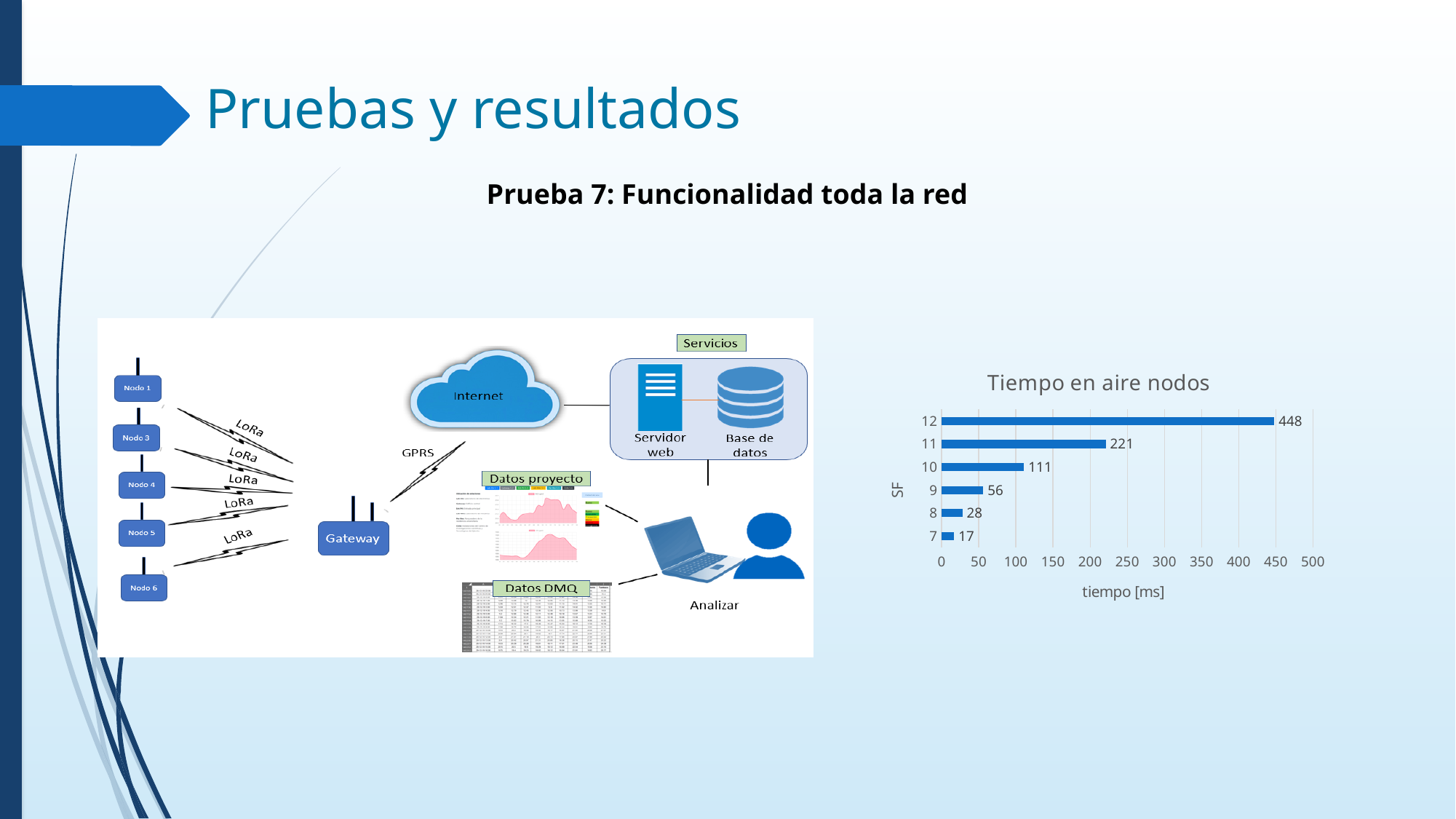
What is the value for SF 12 in the 'Tiempo en aire nodos' chart? 448 How many SF categories are shown in the 'Tiempo en aire nodos' chart? 6 What is the value for SF 9 in the 'Tiempo en aire nodos' chart? 56 Is the value for SF 11 in the 'Tiempo en aire nodos' chart greater or less than 200? greater What is the x-axis label of the 'Tiempo en aire nodos' chart? tiempo [ms] What is the value for SF 7 in the 'Tiempo en aire nodos' chart? 17 What is the difference between the values for SF 12 and SF 11 in the 'Tiempo en aire nodos' chart? 227 What is the difference between the values for SF 10 and SF 8 in the 'Tiempo en aire nodos' chart? 83 Which SF has the lowest time on air in the 'Tiempo en aire nodos' chart? 7 Which SF has the highest time on air in the 'Tiempo en aire nodos' chart? 12 What kind of chart is 'Tiempo en aire nodos'? Bar chart Which has a larger value in the 'Tiempo en aire nodos' chart, SF 10 or SF 9? SF 10